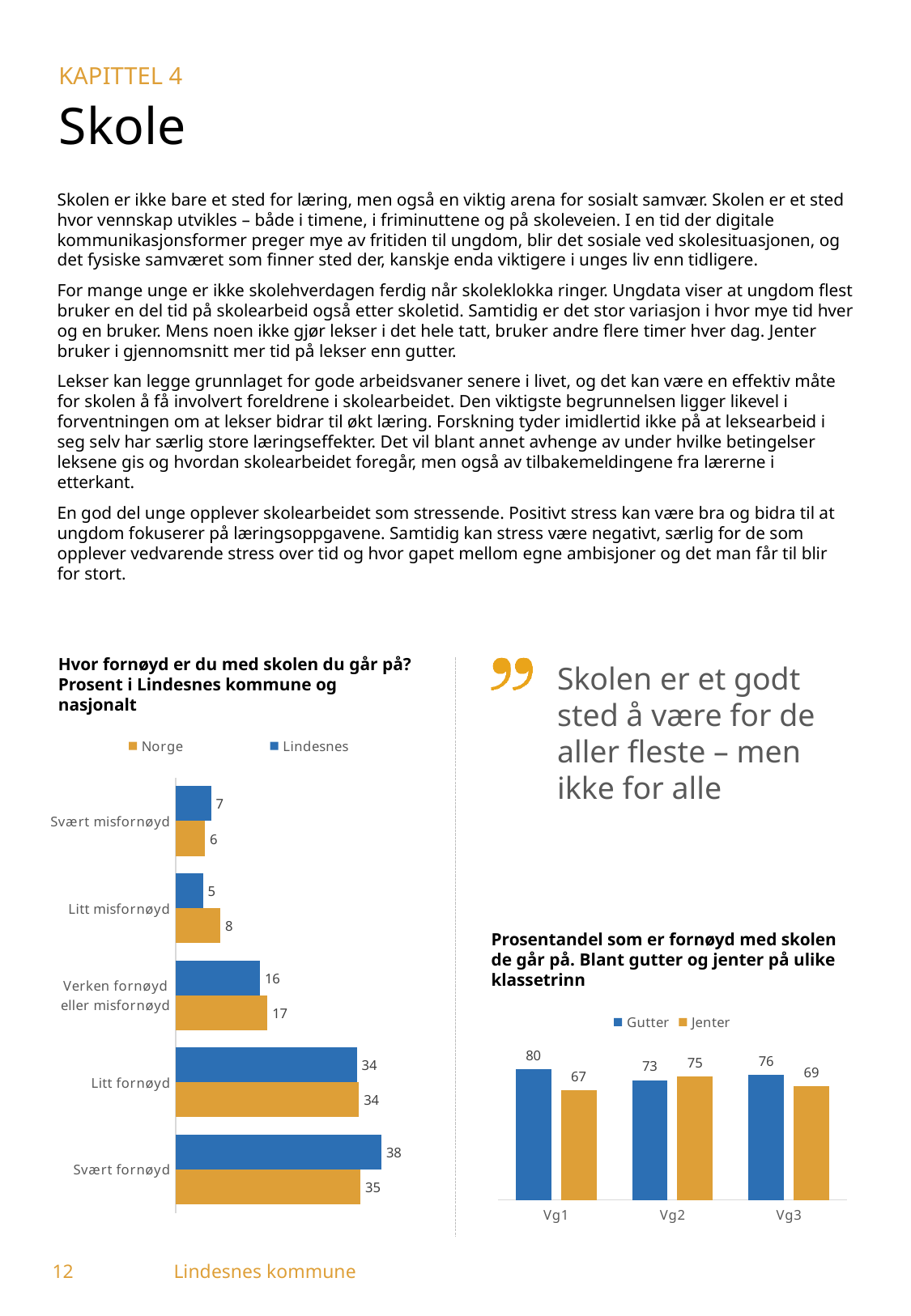
In the chart 'Hvor fornøyd er du med skolen du går på?', which category has the lowest value for Lindesnes? Litt misfornøyd In the chart 'Hvor fornøyd er du med skolen du går på?', what is the difference between the Lindesnes and Norge values for 'Svært fornøyd'? 3 In the chart 'Prosentandel som er fornøyd med skolen de går på', what is the value for Jenter at Vg2? 75 In the chart 'Hvor fornøyd er du med skolen du går på?', which category has the highest value for Lindesnes? Svært fornøyd In the chart 'Hvor fornøyd er du med skolen du går på?', what is the value for Norge in the 'Litt misfornøyd' category? 8 In the chart 'Hvor fornøyd er du med skolen du går på?', how many series does the legend list? 2 In the chart 'Hvor fornøyd er du med skolen du går på?', what is the value for Lindesnes in the 'Svært fornøyd' category? 38 In the chart 'Prosentandel som er fornøyd med skolen de går på', which is larger at Vg3, Gutter or Jenter? Gutter In the chart 'Prosentandel som er fornøyd med skolen de går på', what is the value for Gutter at Vg1? 80 In the chart 'Hvor fornøyd er du med skolen du går på?', how many categories are shown? 5 In the chart 'Prosentandel som er fornøyd med skolen de går på', what is the difference between Gutter and Jenter at Vg1? 13 What kind of chart is 'Prosentandel som er fornøyd med skolen de går på'? Bar chart